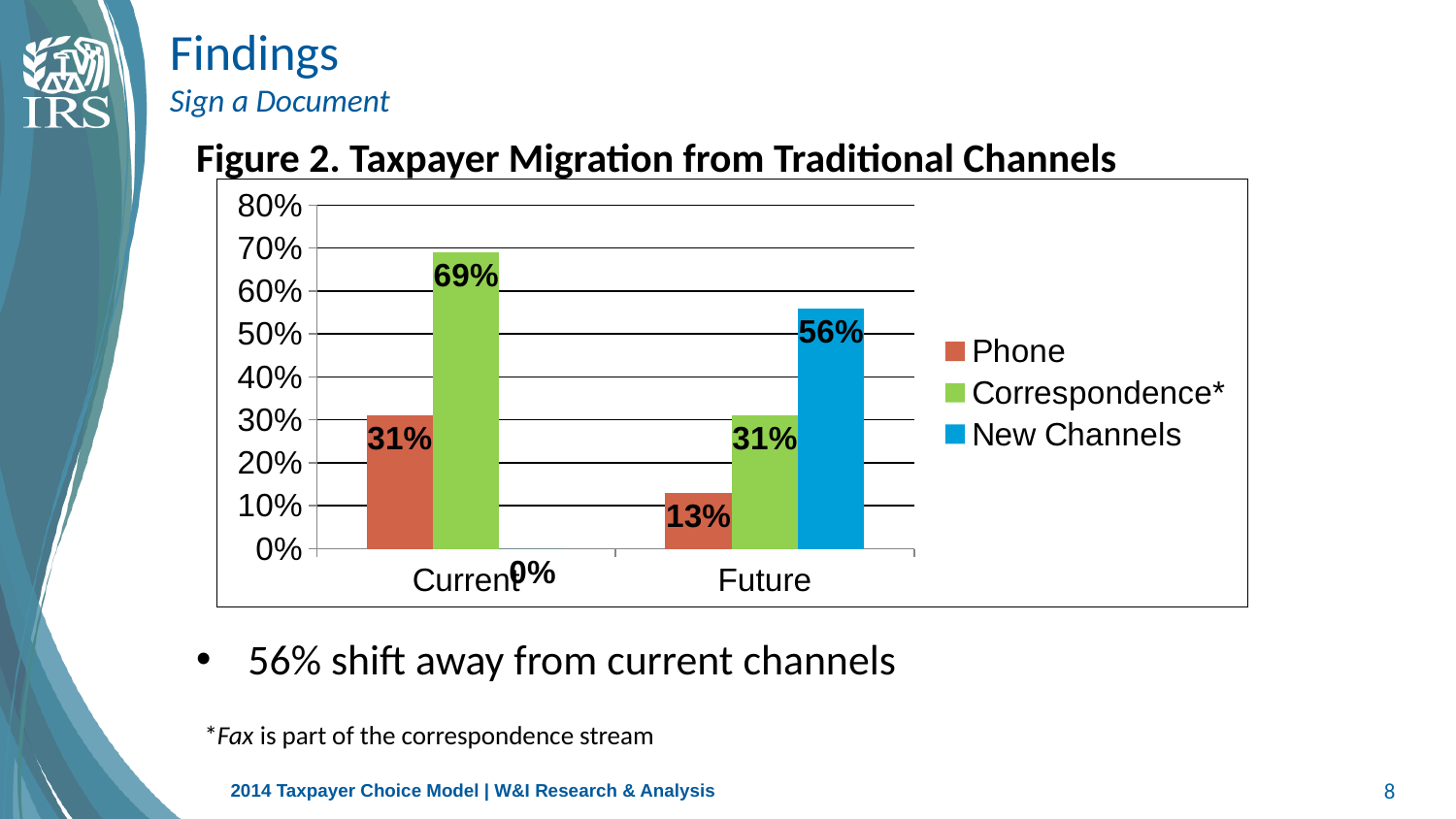
What is the value for Correspondence* in the Current category? 69% What kind of chart is shown? Bar chart What is the value for Phone in the Future category? 13% What is the value for Phone in the Current category? 31% What is the title of the chart? Figure 2. Taxpayer Migration from Traditional Channels What is the value for New Channels in the Current category? 0% What is the value for New Channels in the Future category? 56% Which series has the highest value in the Current category? Correspondence* Which is larger: Phone in Current or Phone in Future? Phone in Current How many series does the legend list? 3 What is the difference between the Correspondence* values for Current and Future? 38% Which series has the lowest value in the Future category? Phone